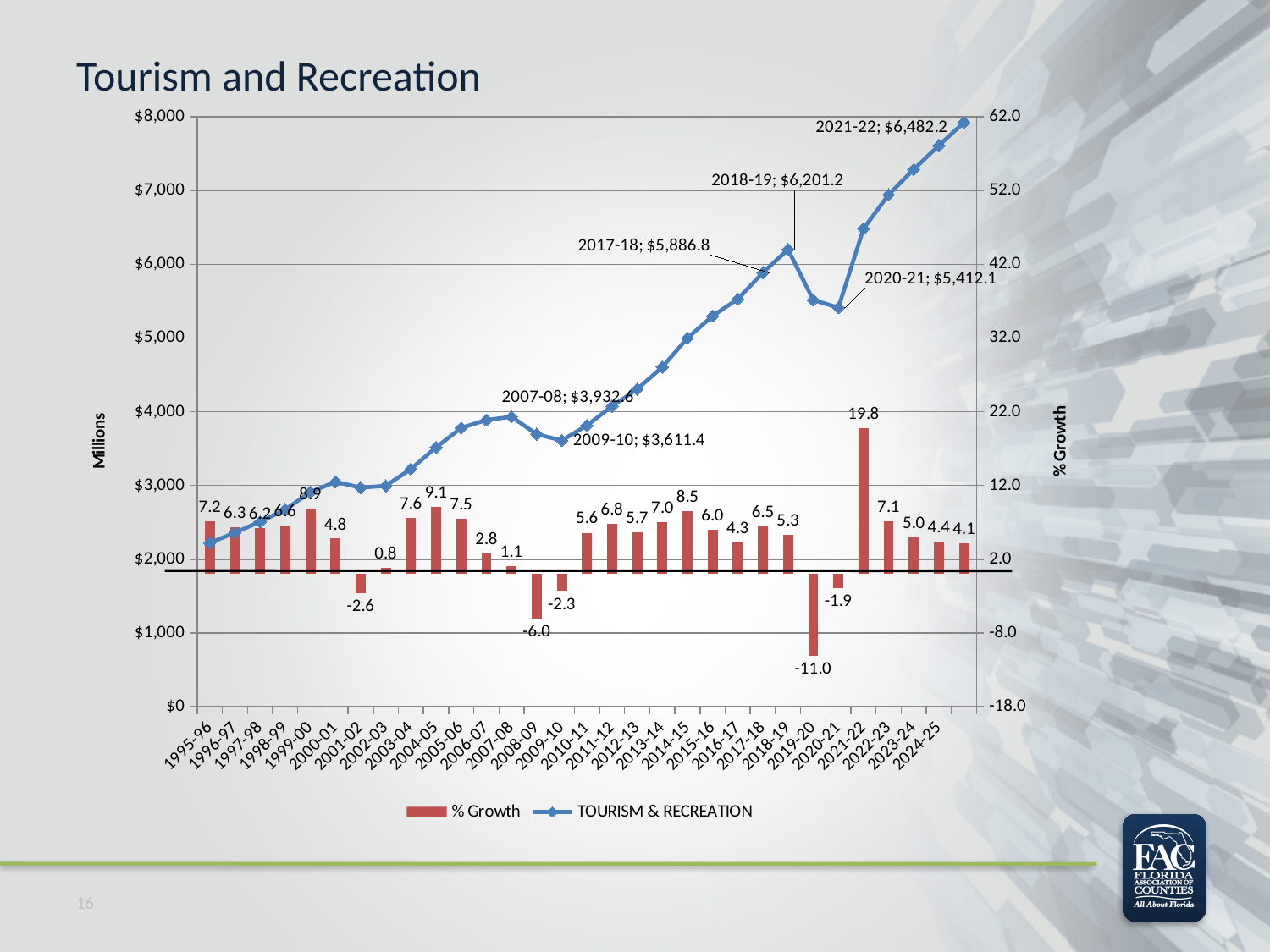
By how much did TOURISM & RECREATION increase from 2017-18 to 2018-19? $314.4 Which year has the highest % Growth? 2021-22 Which year has the larger TOURISM & RECREATION value, 2007-08 or 2009-10? 2007-08 How many series does the legend list? 2 What is the TOURISM & RECREATION value labelled for 2018-19? $6,201.2 What is the % Growth value for 2019-20? -11.0 What is the % Growth value for 2021-22? 19.8 What is the TOURISM & RECREATION value labelled for 2020-21? $5,412.1 Which year has the lowest % Growth? 2019-20 Is the TOURISM & RECREATION value for 2015-16 greater or less than $5,000? greater What kind of chart is shown on the slide? Combination bar and line chart What is the difference between the TOURISM & RECREATION values for 2021-22 and 2020-21? $1,070.1